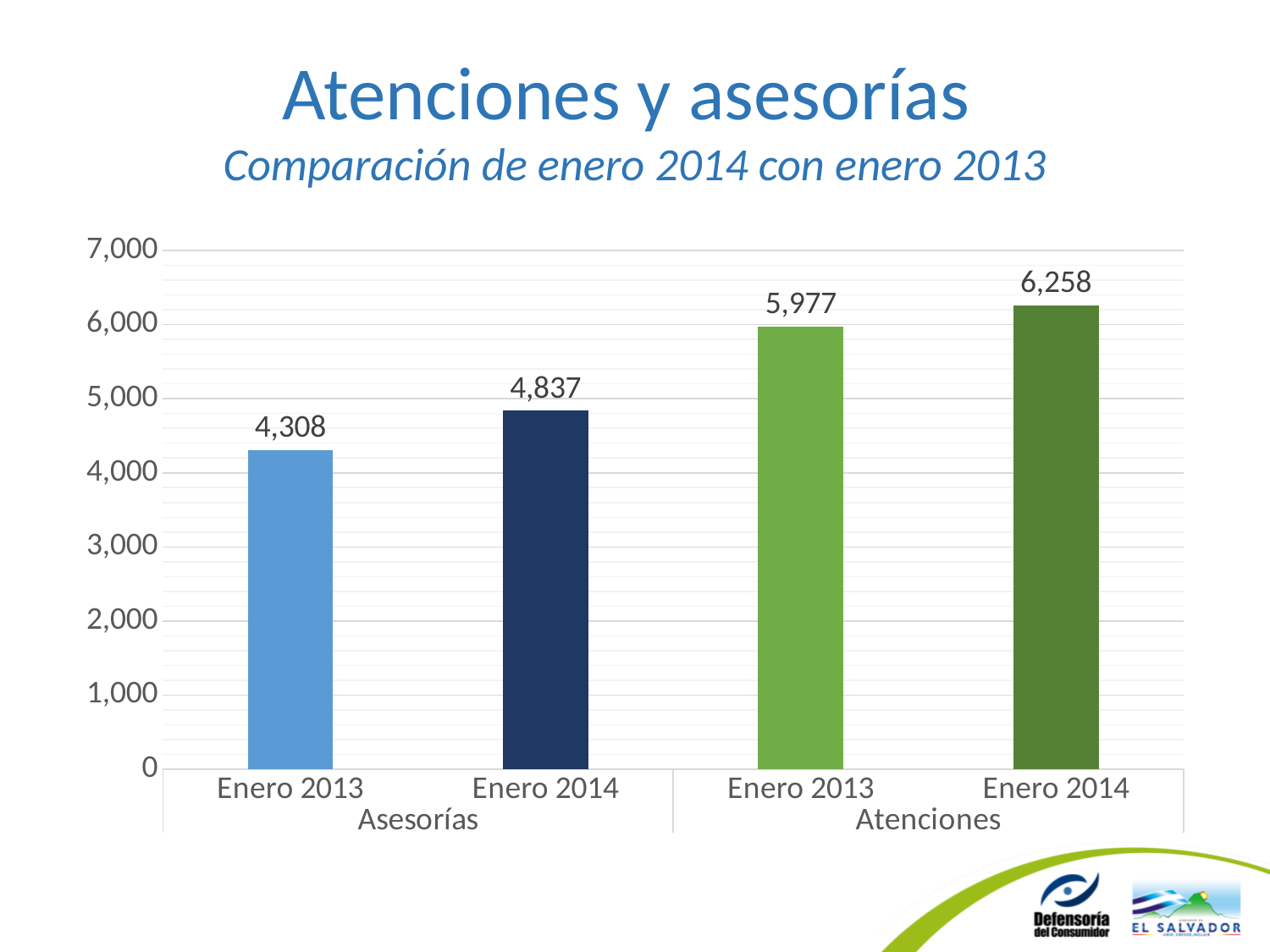
What is the difference between Atenciones in Enero 2014 and Enero 2013? 281 Which bar has the lowest value? Asesorías, Enero 2013 What is the value for Atenciones in Enero 2013? 5,977 What is the difference between Asesorías in Enero 2014 and Enero 2013? 529 Which bar has the highest value? Atenciones, Enero 2014 Is the value for Asesorías in Enero 2014 greater or less than 5,000? less What kind of chart is shown on the slide? Bar chart How many bars are plotted in the chart? 4 What is the value for Asesorías in Enero 2014? 4,837 What is the value for Atenciones in Enero 2014? 6,258 Which is larger: Asesorías in Enero 2014 or Atenciones in Enero 2013? Atenciones in Enero 2013 What is the value for Asesorías in Enero 2013? 4,308